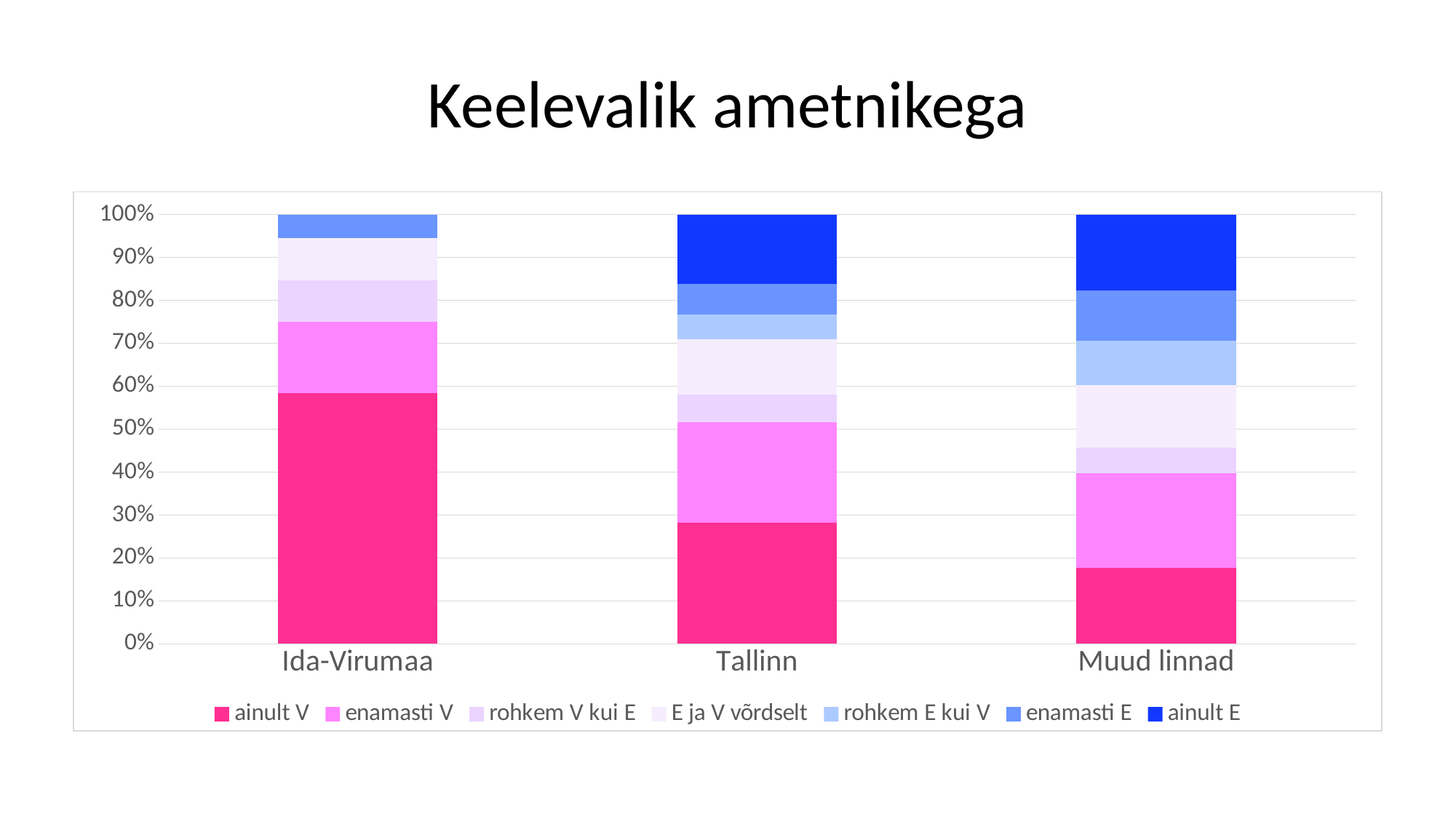
Which category has the highest value for "ainult V"? Ida-Virumaa What is the title of the chart? Keelevalik ametnikega How many categories are shown on the x axis? 3 Is the value for "ainult V" in Muud linnad greater or less than 30%? less How many series does the legend list? 7 What type of chart is shown on the slide? bar chart Which category has the lowest value for "ainult V"? Muud linnad What is the first entry listed in the legend? ainult V What is the total of the stacked bar for Tallinn? 100% Is the value for "ainult V" in Ida-Virumaa greater or less than 50%? greater Which is larger, the "ainult V" value for Ida-Virumaa or for Tallinn? Ida-Virumaa Is the value for "ainult V" in Tallinn greater or less than 40%? less